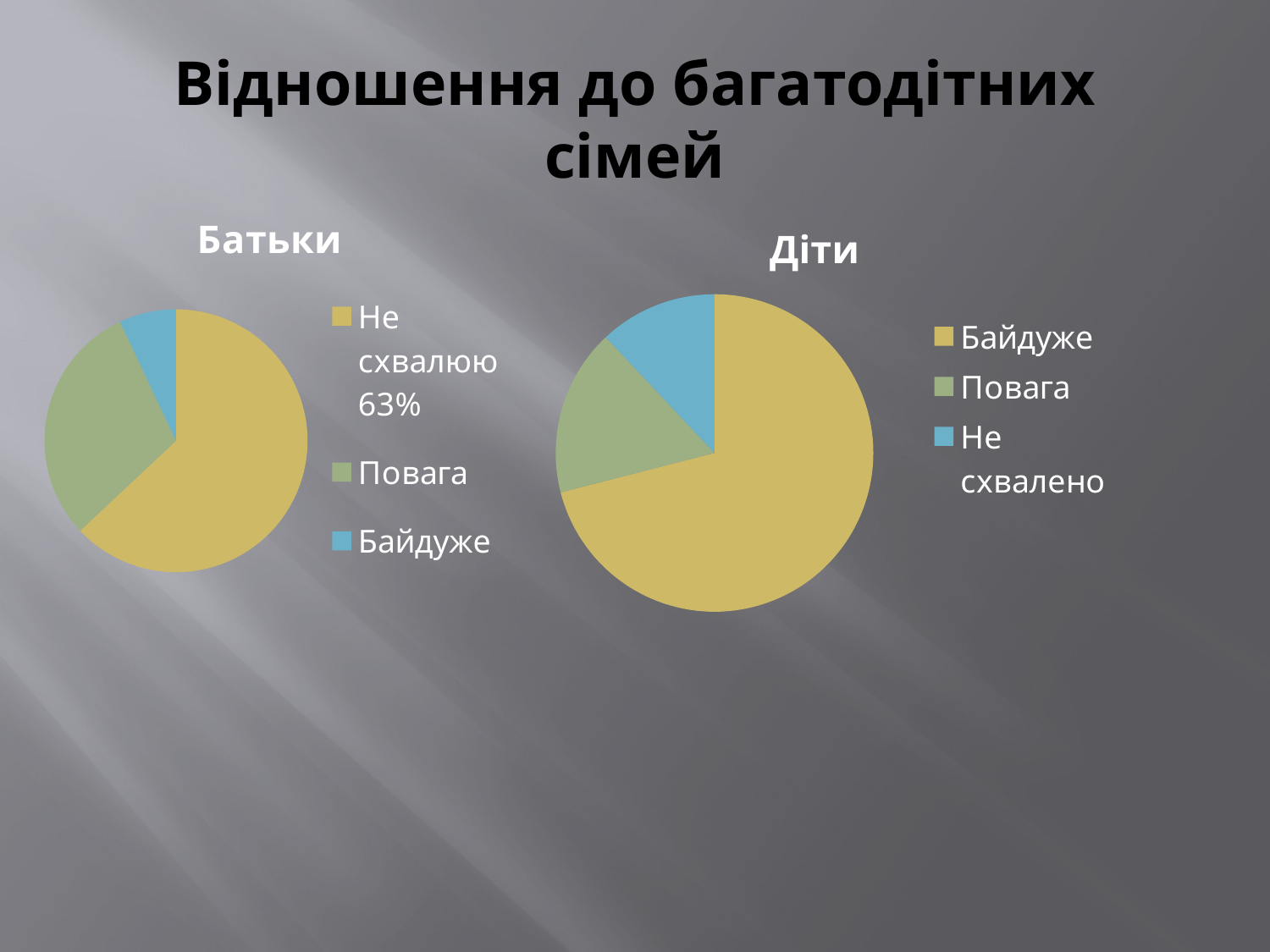
In the "Батьки" chart, which category has the smallest slice? Байдуже In the "Батьки" chart, how many slices does the pie have? 3 What kind of chart is the "Батьки" chart? pie chart What kind of chart is the "Діти" chart? pie chart In the "Батьки" chart, what share is shown for "Не схвалюю"? 63% What is the title of the slide containing the two pie charts? Відношення до багатодітних сімей In the "Діти" chart, how many categories does the legend list? 3 In the "Батьки" chart, which slice is larger: "Повага" or "Байдуже"? Повага In the "Діти" chart, which slice is larger: "Повага" or "Не схвалено"? Повага In the "Діти" chart, which category has the largest slice? Байдуже In the "Батьки" chart, which category has the largest slice? Не схвалюю In the "Діти" chart, which category has the smallest slice? Не схвалено